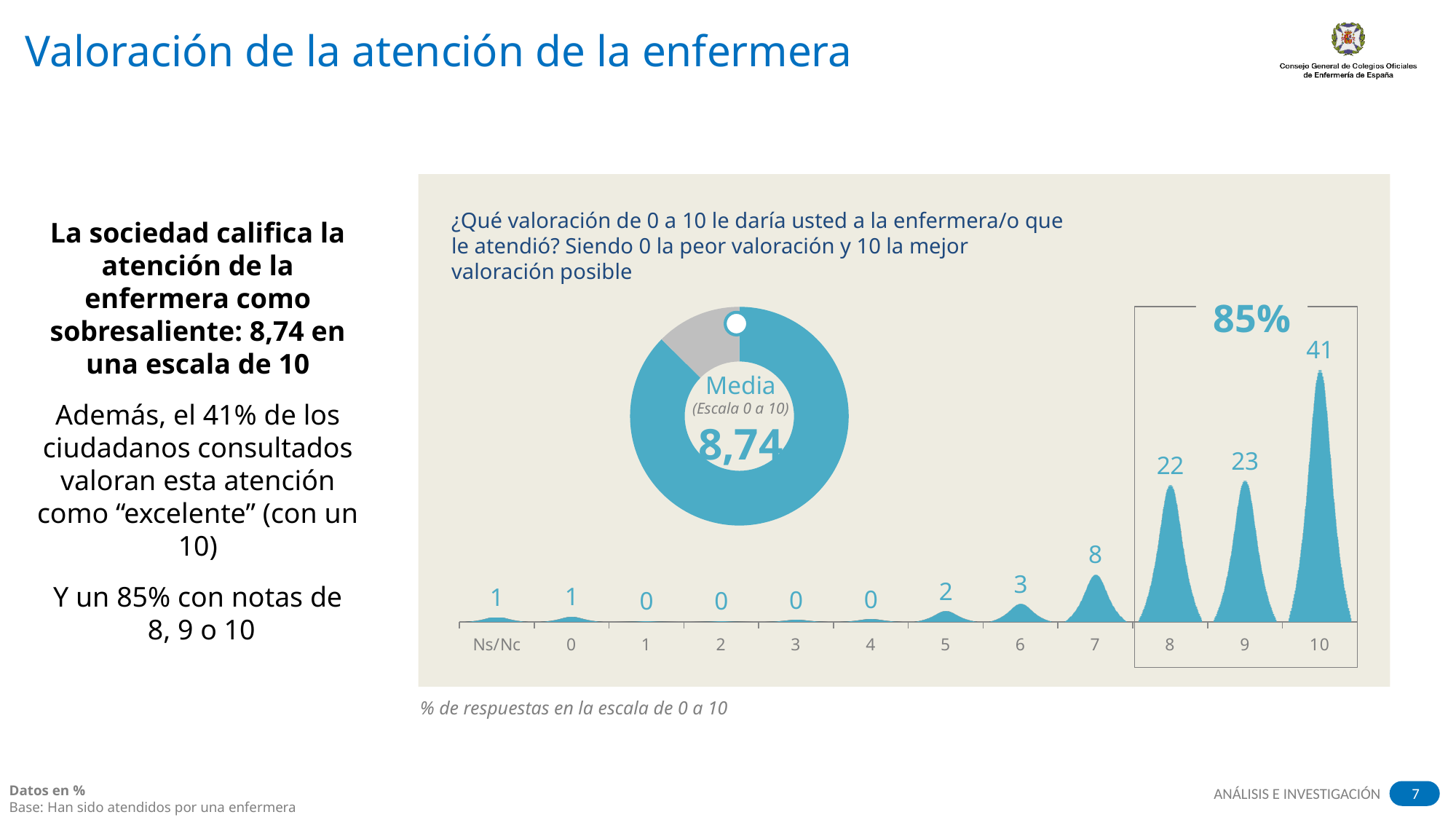
What scale does the donut chart say the mean is measured on? Escala 0 a 10 How many categories are shown along the x axis of the distribution chart? 12 In the distribution chart, what is the combined percentage for ratings 8, 9 and 10? 86 In the distribution chart, what percentage of respondents gave a rating of 8? 22 In the distribution chart, which has a larger percentage: rating 9 or rating 8? 9 In the distribution chart, which rating has the highest percentage of responses? 10 In the distribution chart, what value is shown for Ns/Nc? 1 What mean value (Media) is shown in the centre of the donut chart? 8,74 In the distribution chart, what is the difference between the percentages for ratings 10 and 9? 18 In the distribution chart, what value is shown for rating 5? 2 In the distribution chart, what percentage of respondents gave a rating of 7? 8 In the distribution chart, what percentage of respondents gave a rating of 10? 41